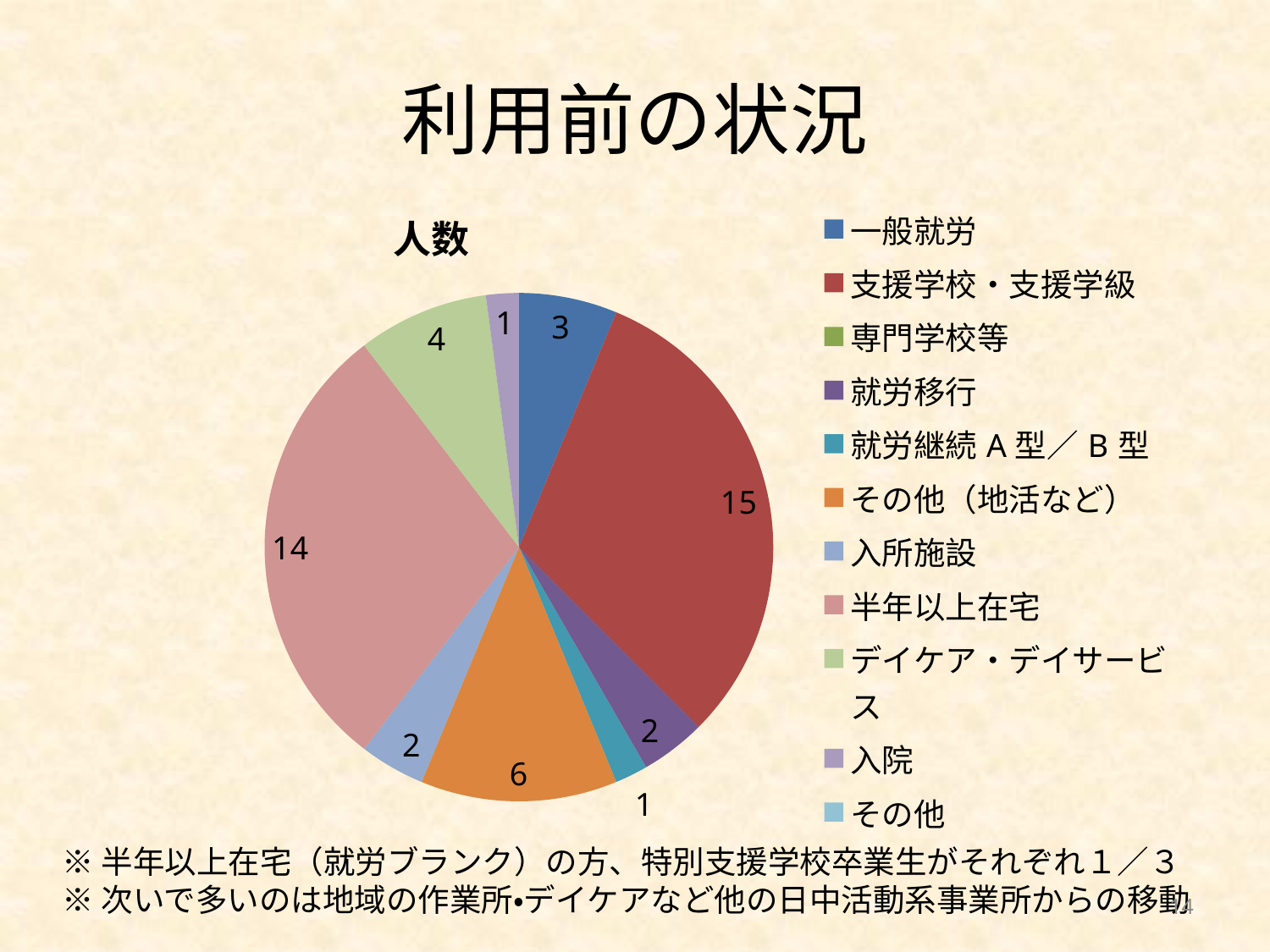
How many entries does the legend list? 11 What type of chart is shown on the slide? pie chart What is the value for 半年以上在宅? 14 What is the title of the chart? 人数 What is the value for 支援学校・支援学級? 15 What is the value for 一般就労? 3 What is the value for その他（地活など）? 6 Which is larger, the value for その他（地活など） or the value for デイケア・デイサービス? その他（地活など） What is the value for デイケア・デイサービス? 4 What is the difference between the values for その他（地活など） and 入所施設? 4 Which category has the largest slice of the pie? 支援学校・支援学級 What is the difference between the values for 支援学校・支援学級 and 半年以上在宅? 1